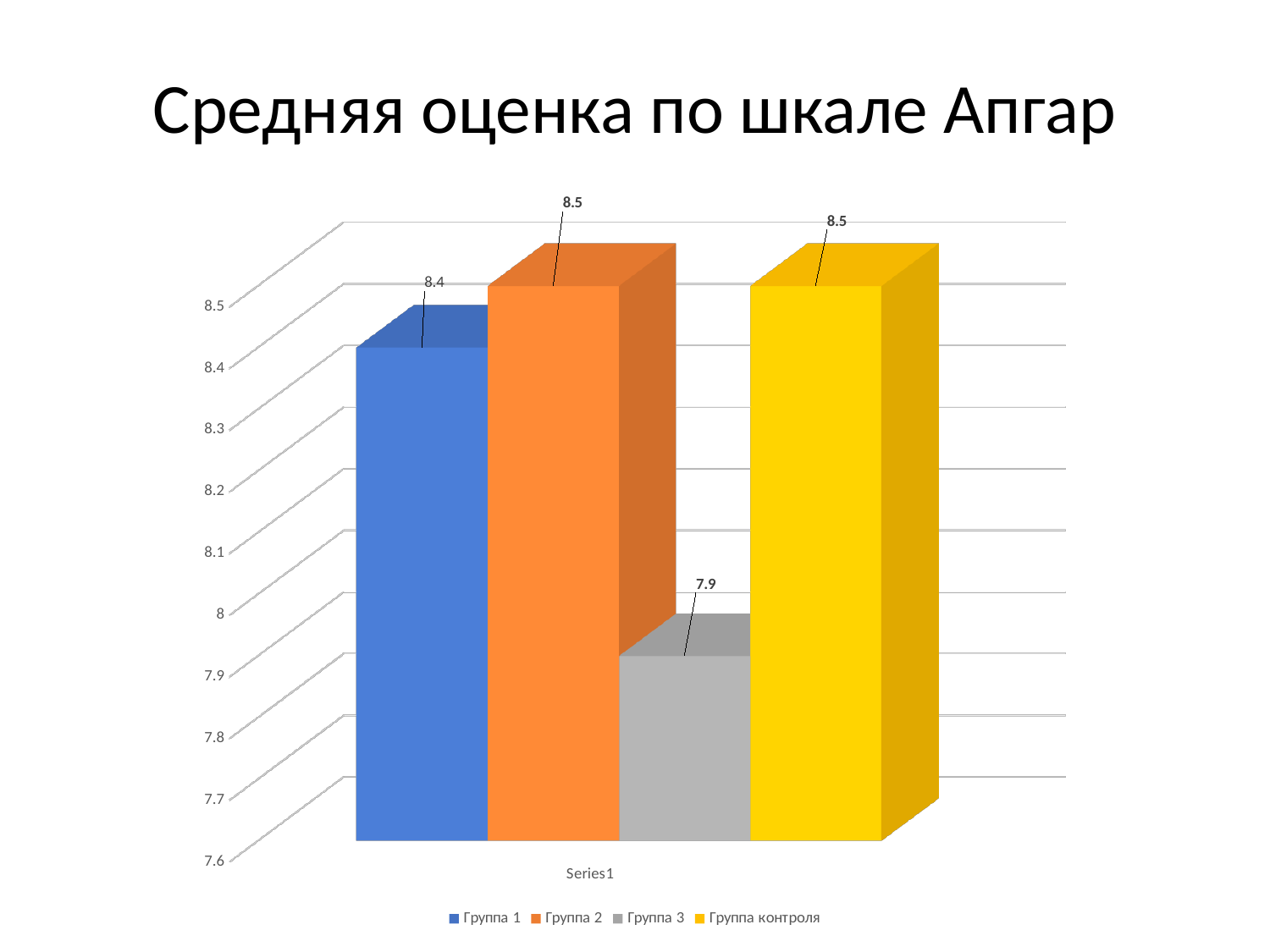
What is the value for Группа 1? 8.4 What is the difference between the values for Группа 2 and Группа 3? 0.6 What is the value for Группа контроля? 8.5 What is the title of the slide? Средняя оценка по шкале Апгар What kind of chart is shown on the slide? bar chart How many entries does the legend list? 4 Which is larger, the value for Группа 1 or the value for Группа 3? Группа 1 Is the value for Группа 3 greater or less than 8? less Which group has the lowest value? Группа 3 What is the difference between the values for Группа контроля and Группа 1? 0.1 How many bars are shown in the chart? 4 What is the value for Группа 3? 7.9